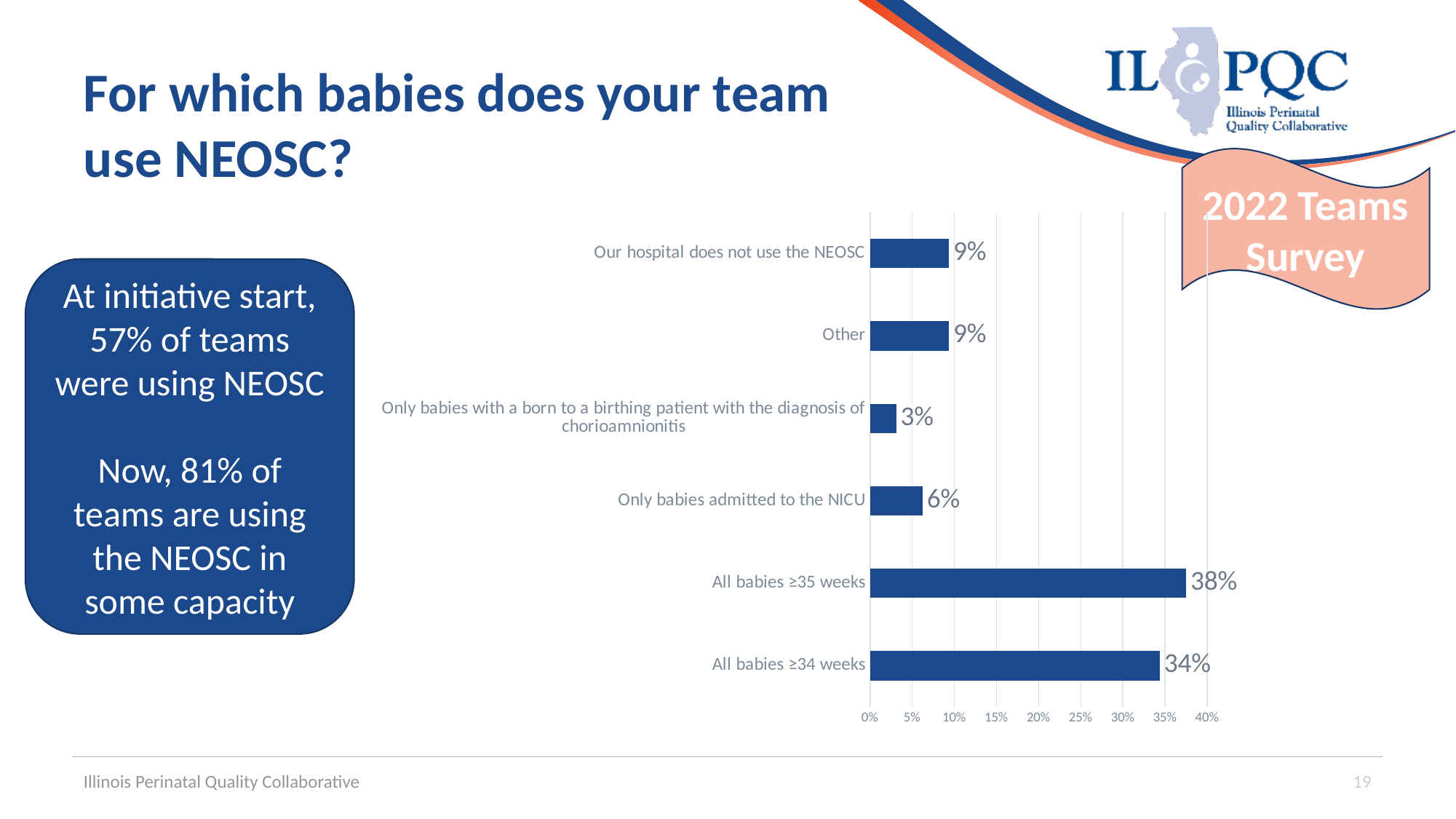
What percentage of teams use NEOSC only for babies admitted to the NICU? 6% Is the value for all babies ≥35 weeks greater or less than 35%? greater Which category has the highest value in the chart? All babies ≥35 weeks What percentage of teams use NEOSC for all babies ≥34 weeks? 34% How many categories are shown in the chart? 6 What is the difference between the values for all babies ≥35 weeks and all babies ≥34 weeks? 4% What percentage of teams reported that their hospital does not use the NEOSC? 9% Which is larger: the value for 'Only babies admitted to the NICU' or the value for 'Other'? Other What percentage of teams use NEOSC for all babies ≥35 weeks? 38% What kind of chart is shown on the slide? bar chart Which category has the lowest value in the chart? Only babies with a born to a birthing patient with the diagnosis of chorioamnionitis What is the maximum value shown on the chart's percentage axis? 40%